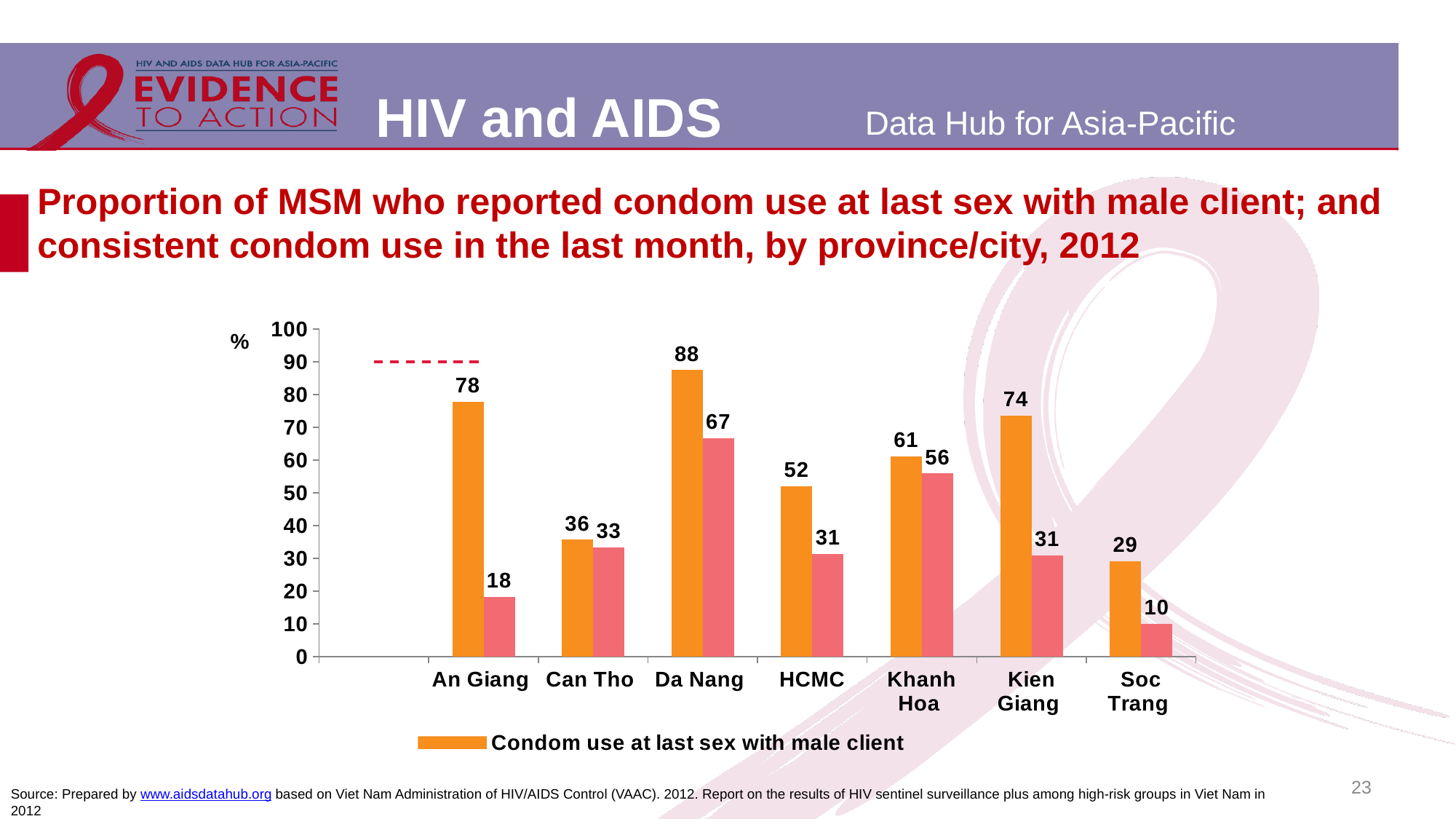
Which is larger: the orange bar for Khanh Hoa or the orange bar for Kien Giang? Kien Giang What is the value for condom use at last sex with male client in Da Nang? 88 What colour are the bars for condom use at last sex with male client? orange How many provinces/cities are shown on the x axis? 7 What kind of chart is shown on the slide? bar chart Which province/city has the lowest value for the pink bars (consistent condom use in the last month)? Soc Trang What is the difference between condom use at last sex with male client in Kien Giang and in HCMC? 22 What is the value of the pink bar (consistent condom use in the last month) for An Giang? 18 What is the difference between the orange and pink bars for An Giang? 60 Is the value for condom use at last sex with male client in Can Tho greater or less than 50? less What is the value for condom use at last sex with male client in Soc Trang? 29 Which province/city has the highest value for condom use at last sex with male client? Da Nang